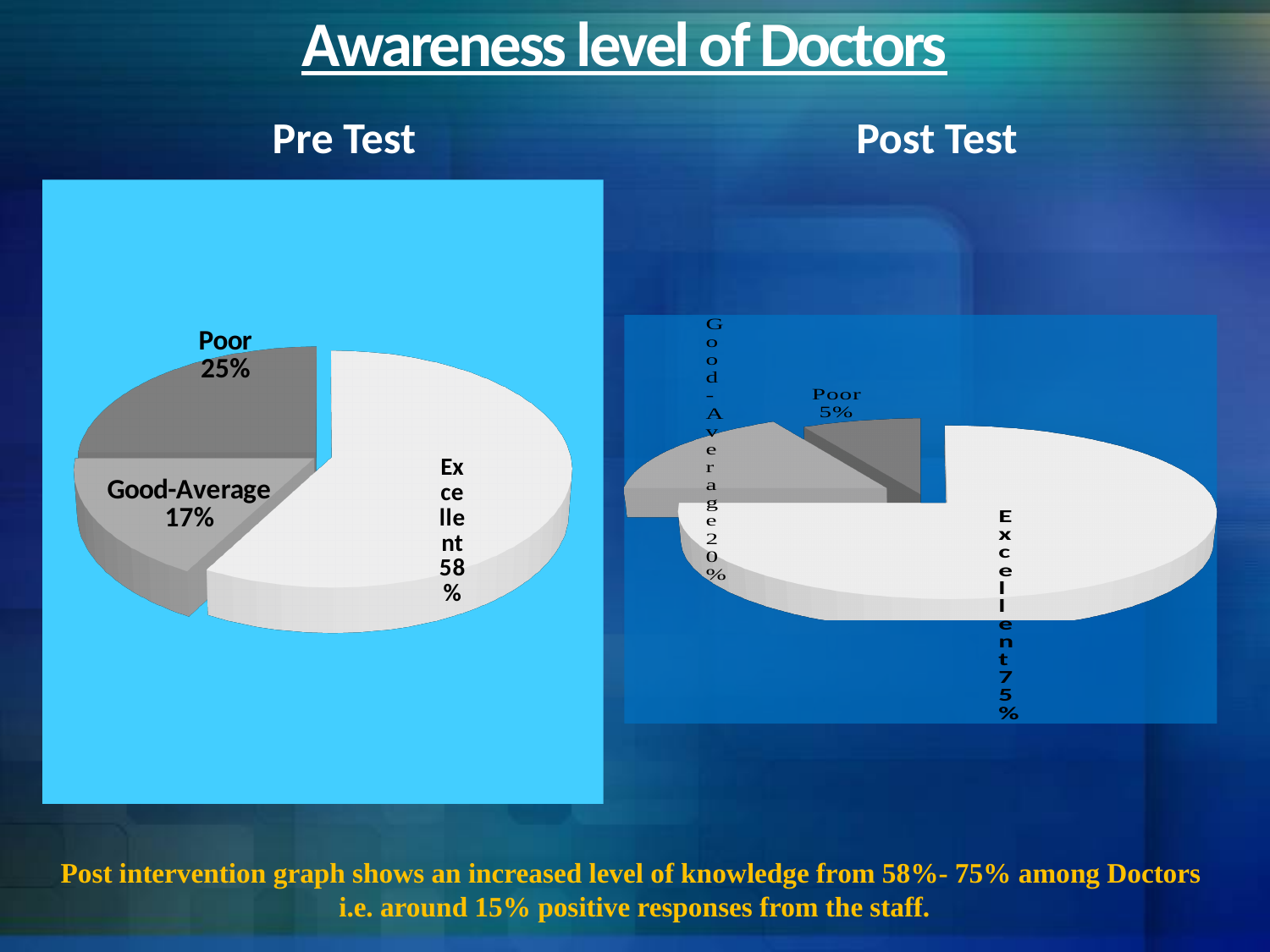
What type of chart is the Pre Test chart? Pie chart In the Post Test chart, what percentage is labelled Excellent? 75% In the Pre Test chart, what percentage is labelled Excellent? 58% In the Pre Test chart, what percentage is labelled Good-Average? 17% What is the difference between the Excellent share in the Post Test chart and the Excellent share in the Pre Test chart? 17% In the Pre Test chart, which is larger: the Poor share or the Good-Average share? Poor In the Post Test chart, what percentage is labelled Good-Average? 20% In the Pre Test chart, which category has the largest share? Excellent How many slices does the Post Test chart have? 3 In the Post Test chart, what percentage is labelled Poor? 5% In the Pre Test chart, what percentage is labelled Poor? 25% In the Post Test chart, which category has the smallest share? Poor